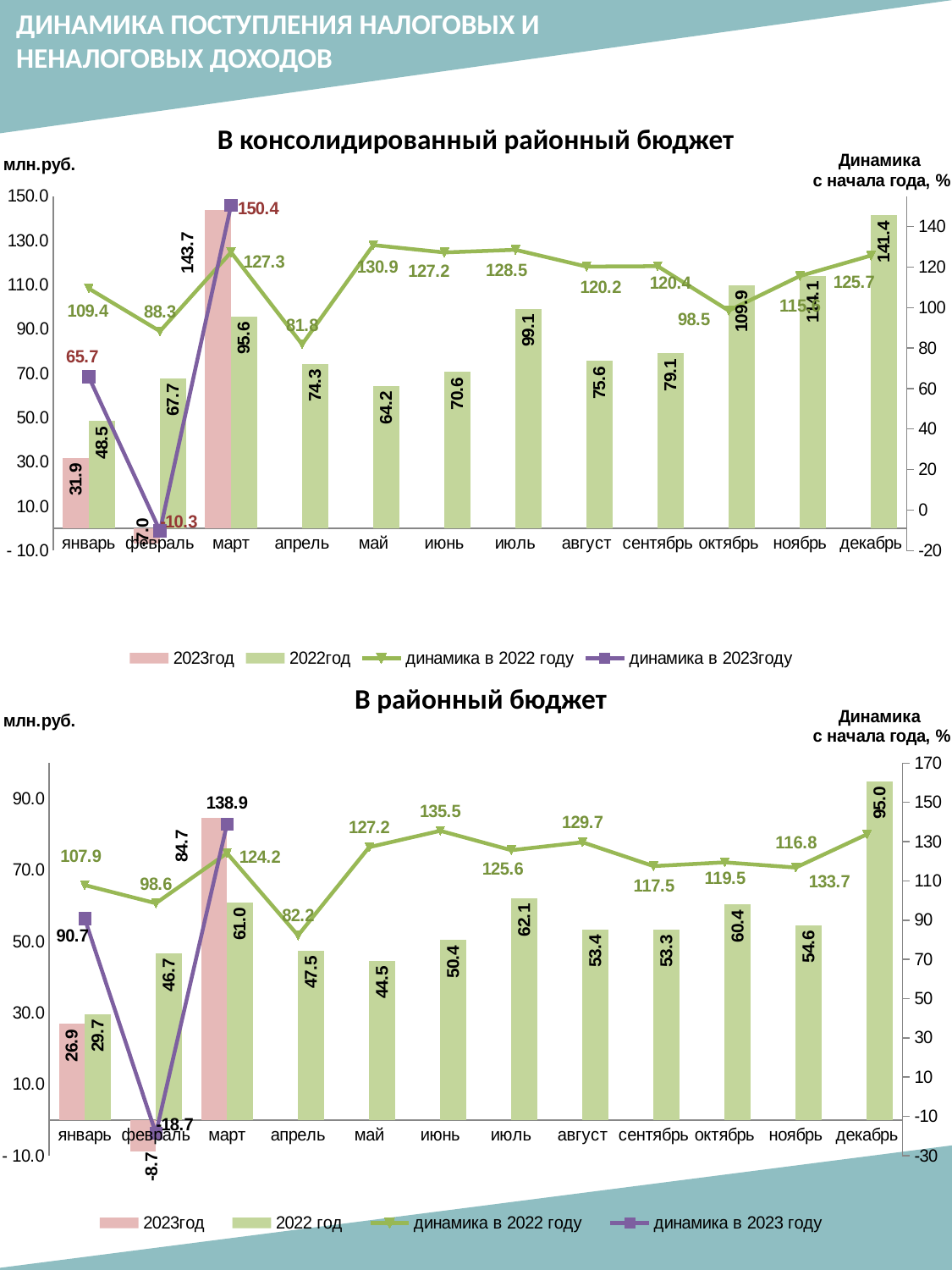
In the chart 'В консолидированный районный бюджет', how many series does the legend list? 4 In the chart 'В районный бюджет', how many months are shown on the x axis? 12 In the chart 'В районный бюджет', what is the value of 'динамика в 2022 году' for июнь? 135.5 In the chart 'В консолидированный районный бюджет', what is the value of the 2023 bar for март? 143.7 In the chart 'В консолидированный районный бюджет', which month has the lowest 2022 bar? январь In the chart 'В консолидированный районный бюджет', what is the value of the 2022 bar for декабрь? 141.4 In the chart 'В консолидированный районный бюджет', what is the value of 'динамика в 2023году' for февраль? -10.3 In the chart 'В районный бюджет', what is the value of 'динамика в 2023 году' for март? 138.9 In the chart 'В консолидированный районный бюджет', what is the difference between the 2022 bars for март and январь? 47.1 In the chart 'В районный бюджет', which month has the highest 2022 bar? декабрь In the chart 'В районный бюджет', which is larger: the 2023 bar for январь or the 2022 bar for январь? 2022 bar for январь In the chart 'В районный бюджет', what is the value of the 2022 bar for июль? 62.1